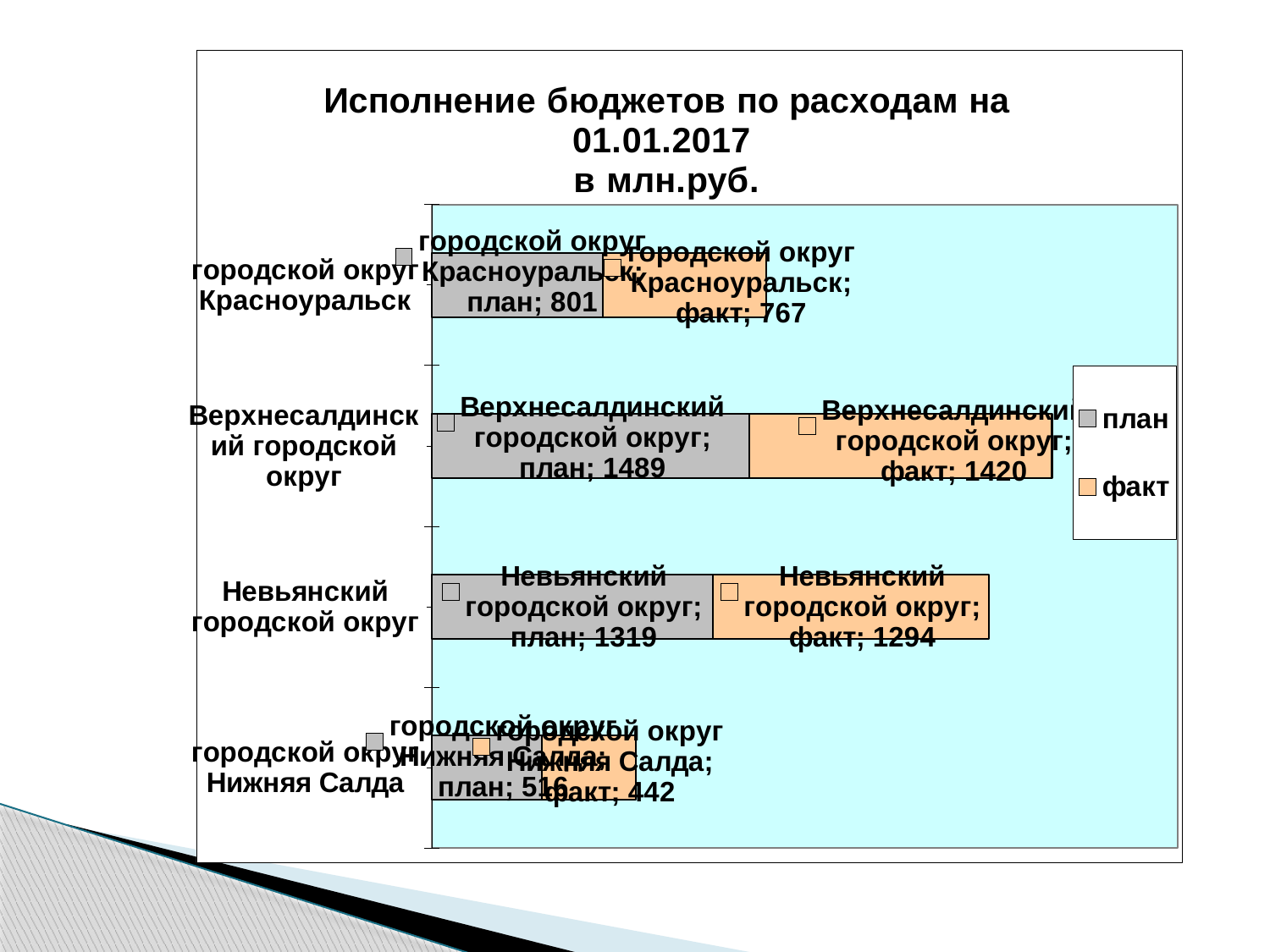
What type of chart is shown on the slide? bar chart Which category has the highest план value? Верхнесалдинский городской округ Which category has the lowest факт value? городской округ Нижняя Салда What is the title of the chart? Исполнение бюджетов по расходам на 01.01.2017 в млн.руб. How many categories (городские округа) are shown in the chart? 4 What is the факт value for Верхнесалдинский городской округ? 1420 What is the факт value for городской округ Красноуральск? 767 What is the факт value for городской округ Нижняя Салда? 442 How many series does the legend list? 2 What is the план value for Верхнесалдинский городской округ? 1489 What is the difference between the план and факт values for Невьянский городской округ? 25 What is the план value for Невьянский городской округ? 1319